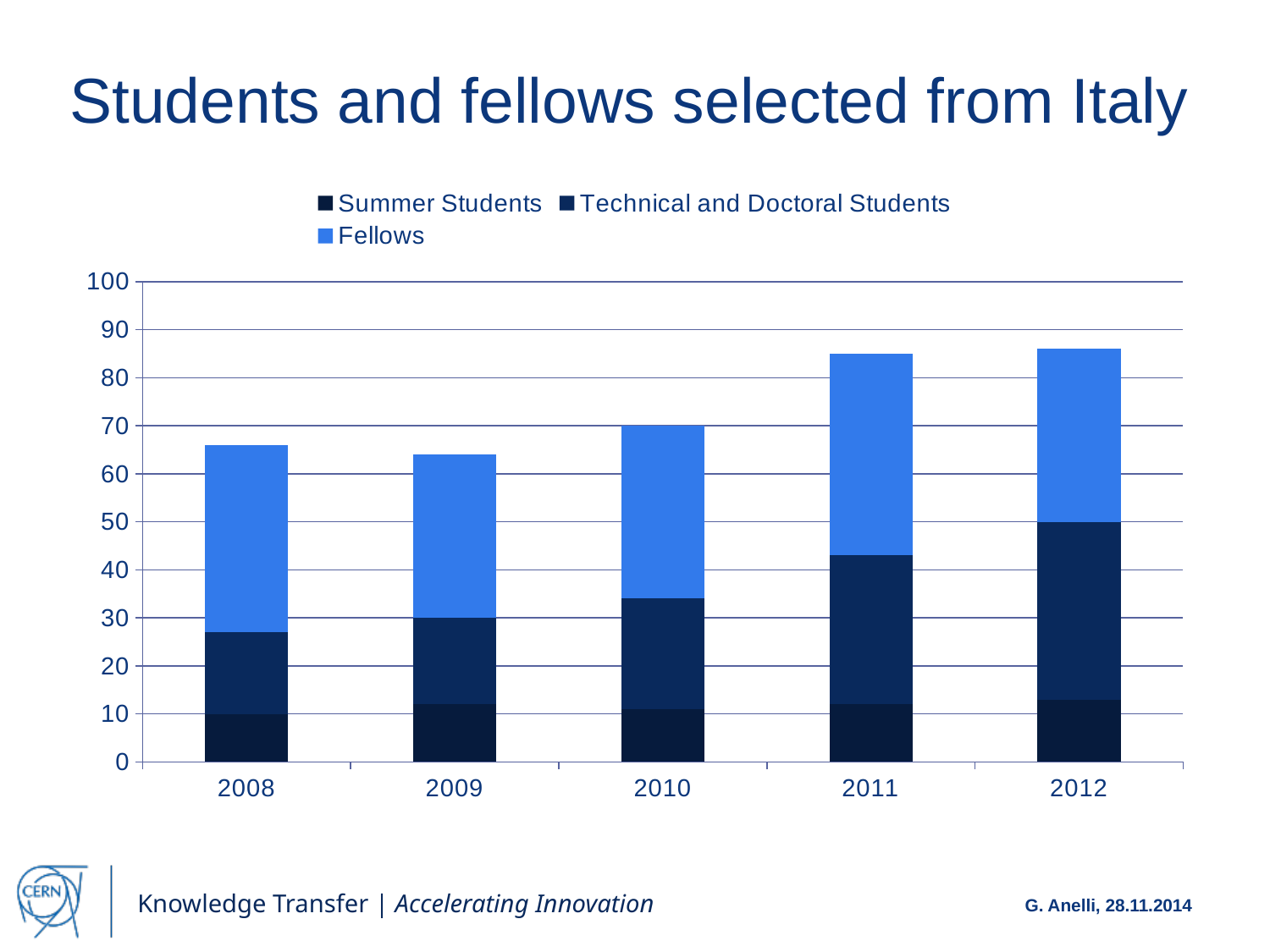
How many years are shown on the x axis of the chart? 5 Is the total stacked bar for 2012 higher or lower than the total for 2008? higher Is the total stacked bar for 2012 greater or less than 80? greater Is the total stacked bar for 2011 greater or less than 80? greater Which year has the larger total stacked bar, 2010 or 2009? 2010 What is the title of the chart on the slide? Students and fellows selected from Italy Which series is shown in the lightest blue colour in the chart? Fellows Is the total stacked bar for 2009 greater or less than 60? greater How many series does the chart legend list? 3 What kind of chart is shown on the slide? Stacked bar chart Which year has the larger total stacked bar, 2011 or 2008? 2011